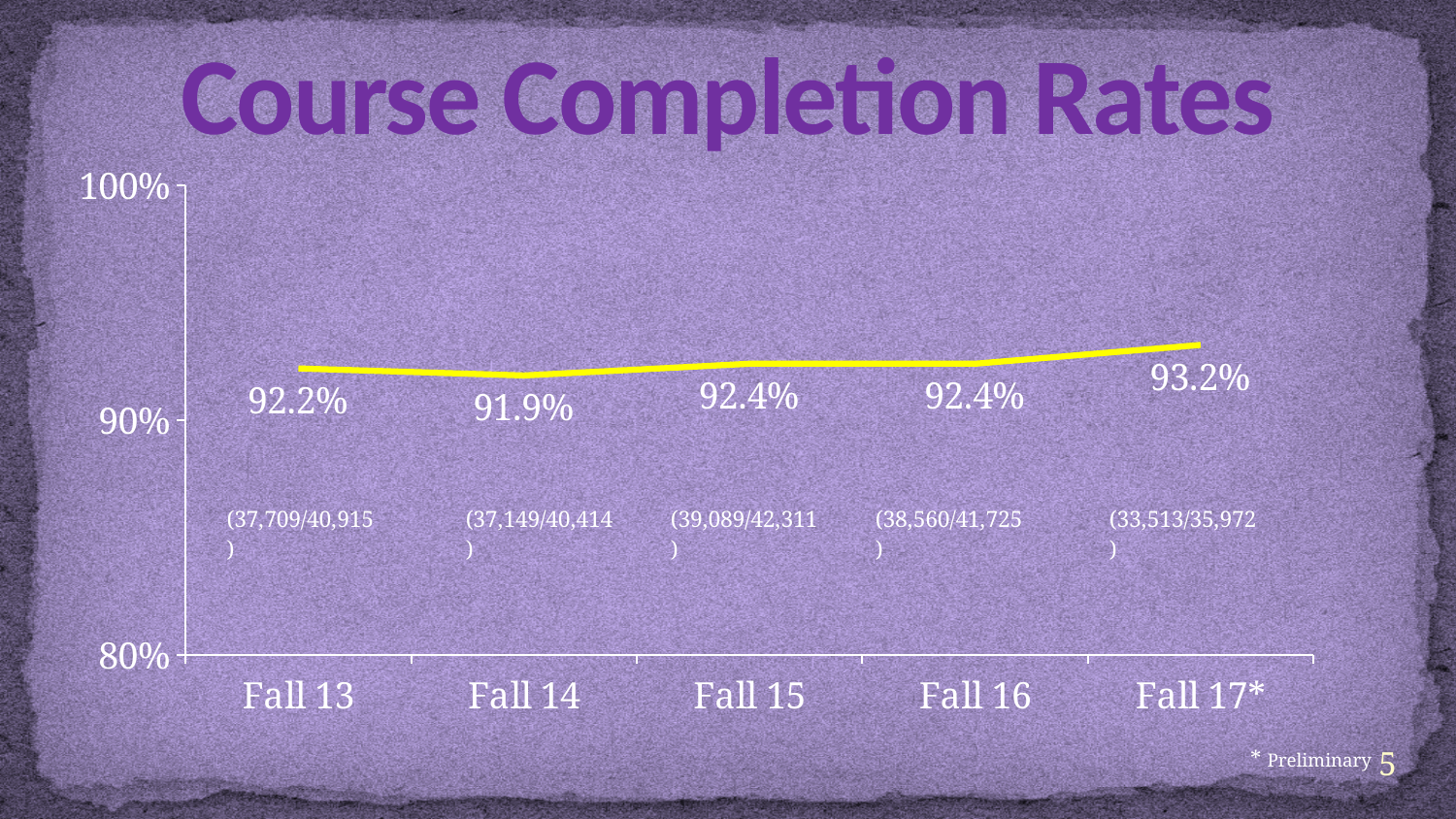
What kind of chart is shown on the slide? line chart Do the completion rates rise or fall from Fall 14 to Fall 17*? rise Which is larger, the completion rate for Fall 13 or Fall 14? Fall 13 What is the difference between the completion rates for Fall 17* and Fall 14? 1.3% How many terms are plotted on the chart? 5 Which term has the lowest course completion rate? Fall 14 Is the value for Fall 16 greater or less than 90%? greater Which term has the highest course completion rate? Fall 17* What is the course completion rate for Fall 17*? 93.2% What is the title of the chart? Course Completion Rates What is the course completion rate for Fall 13? 92.2% What is the course completion rate for Fall 14? 91.9%